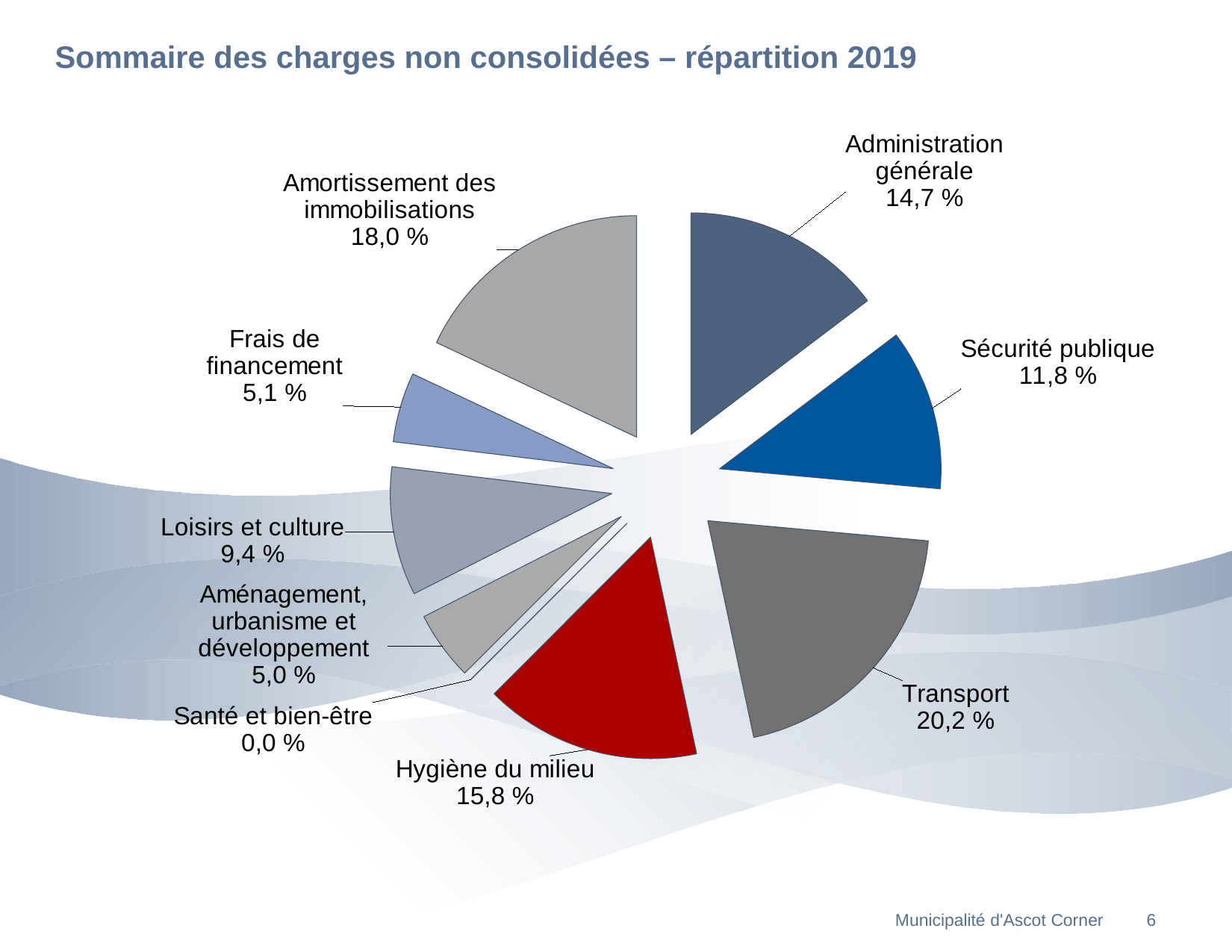
What colour is the Hygiène du milieu slice? red Which category has the smallest share of the pie? Santé et bien-être What is the title of the slide? Sommaire des charges non consolidées – répartition 2019 What percentage is shown for Hygiène du milieu? 15,8 % What is the difference between the shares of Amortissement des immobilisations and Sécurité publique? 6,2 % Which category has the largest share of the pie? Transport What is the value for Frais de financement? 5,1 % What is the value shown for Administration générale? 14,7 % What type of chart is shown on the slide? pie chart How many categories are shown in the pie chart? 9 What share does Transport represent in the pie chart? 20,2 % Which is larger, the share for Loisirs et culture or the share for Aménagement, urbanisme et développement? Loisirs et culture